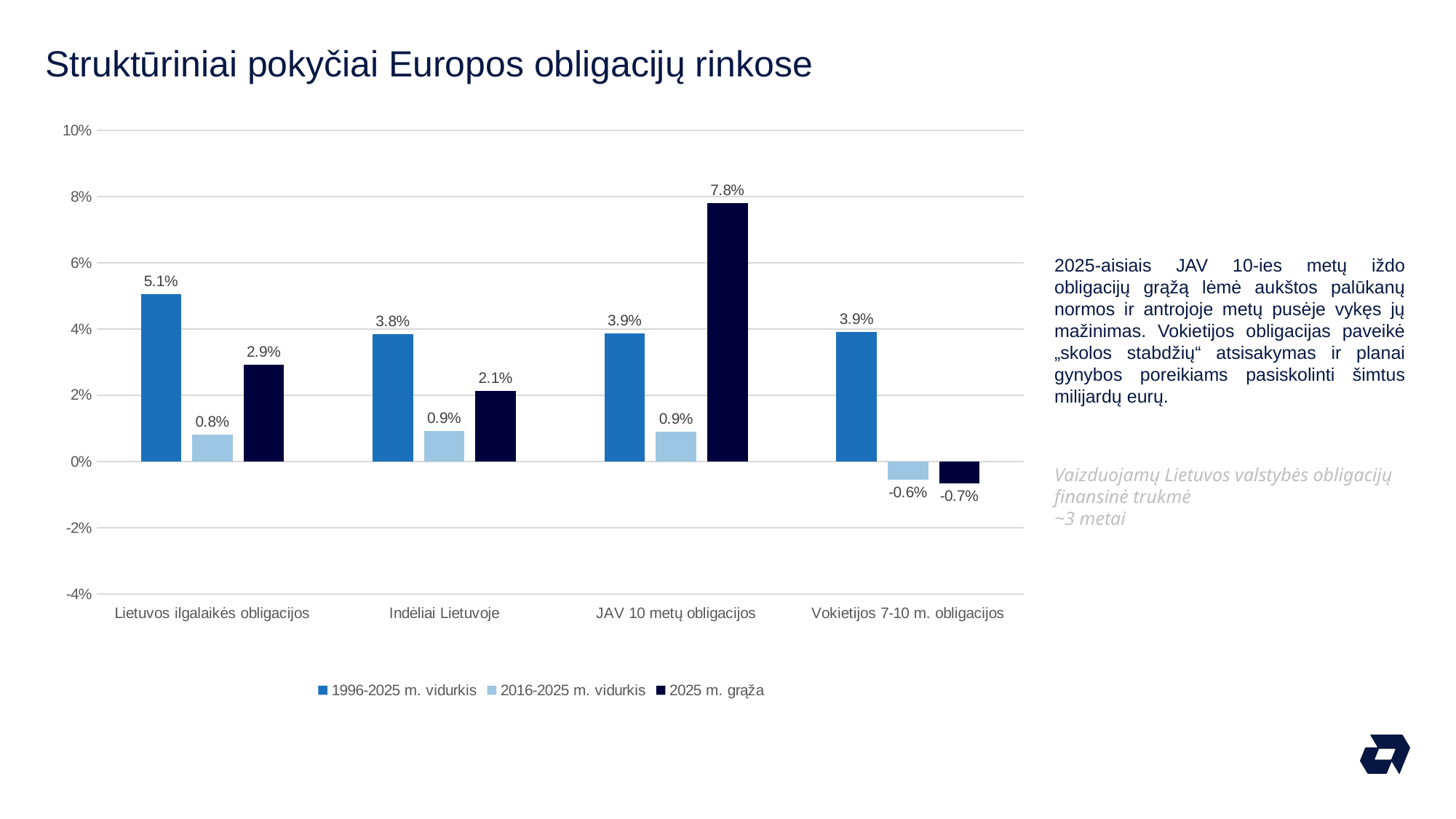
What kind of chart is shown on the slide? Bar chart How many series does the legend list? 3 What is the 1996-2025 m. vidurkis value for Lietuvos ilgalaikės obligacijos? 5.1% What is the 2025 m. grąža value for Indėliai Lietuvoje? 2.1% What is the 2016-2025 m. vidurkis value for Vokietijos 7-10 m. obligacijos? -0.6% How many categories are shown on the x axis? 4 What is the 2025 m. grąža value for JAV 10 metų obligacijos? 7.8% What is the difference between the 2025 m. grąža and the 1996-2025 m. vidurkis for JAV 10 metų obligacijos? 3.9% Which category has the highest 2025 m. grąža value? JAV 10 metų obligacijos Which category has the lowest 2025 m. grąža value? Vokietijos 7-10 m. obligacijos Which is larger for Lietuvos ilgalaikės obligacijos: the 1996-2025 m. vidurkis or the 2025 m. grąža? 1996-2025 m. vidurkis What is the title of the slide? Struktūriniai pokyčiai Europos obligacijų rinkose